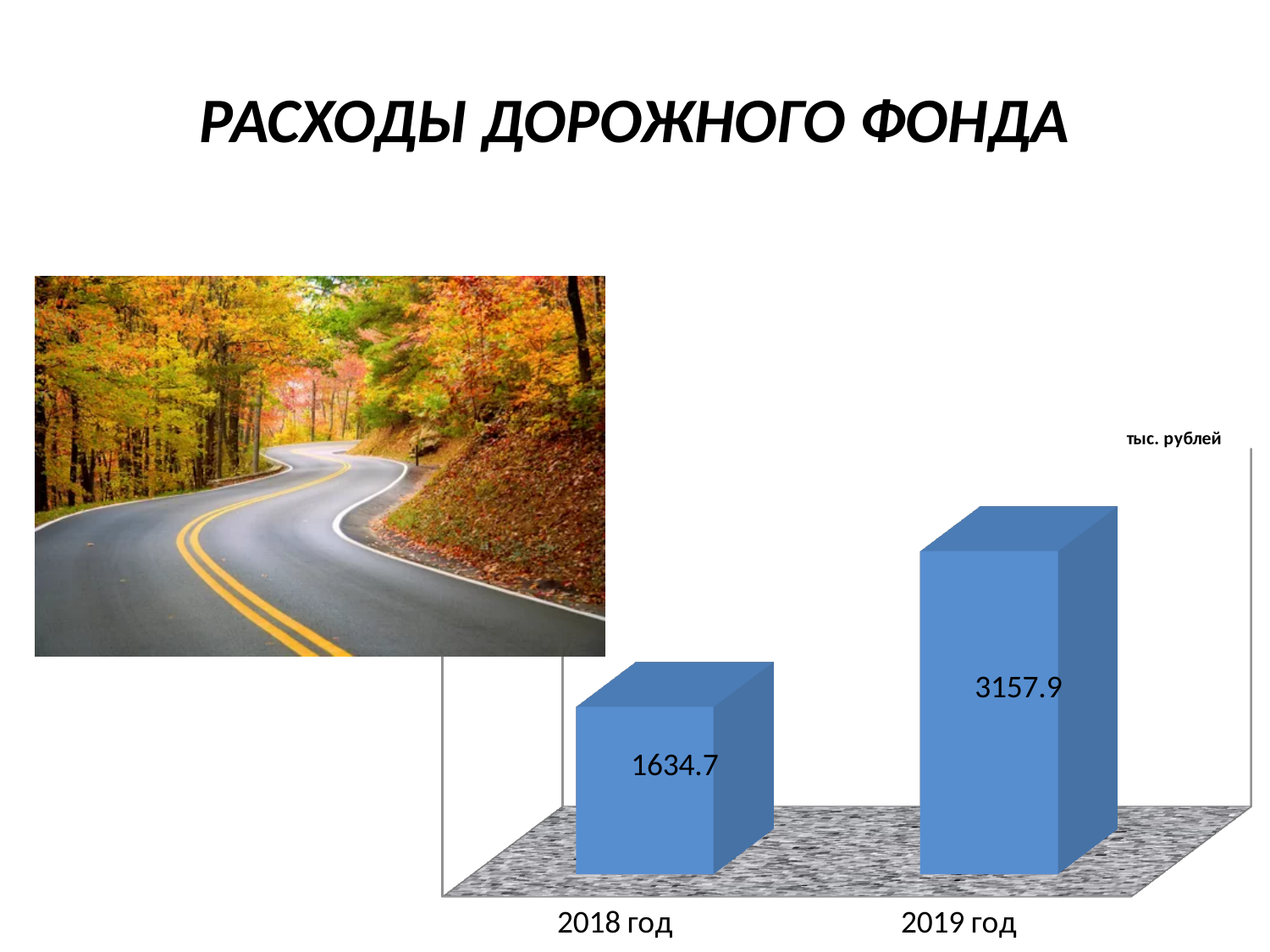
Which year has the highest value? 2019 год What kind of chart is shown on the slide? Bar chart How many categories are shown in the chart? 2 Which year has the lowest value? 2018 год What is the value for 2019 год? 3157.9 What unit is indicated for the chart values? тыс. рублей What is the value for 2018 год? 1634.7 What is the title of the slide containing the chart? РАСХОДЫ ДОРОЖНОГО ФОНДА Which is larger, the value for 2018 год or 2019 год? 2019 год Do the values rise or fall from 2018 год to 2019 год? Rise What is the difference between the values for 2019 год and 2018 год? 1523.2